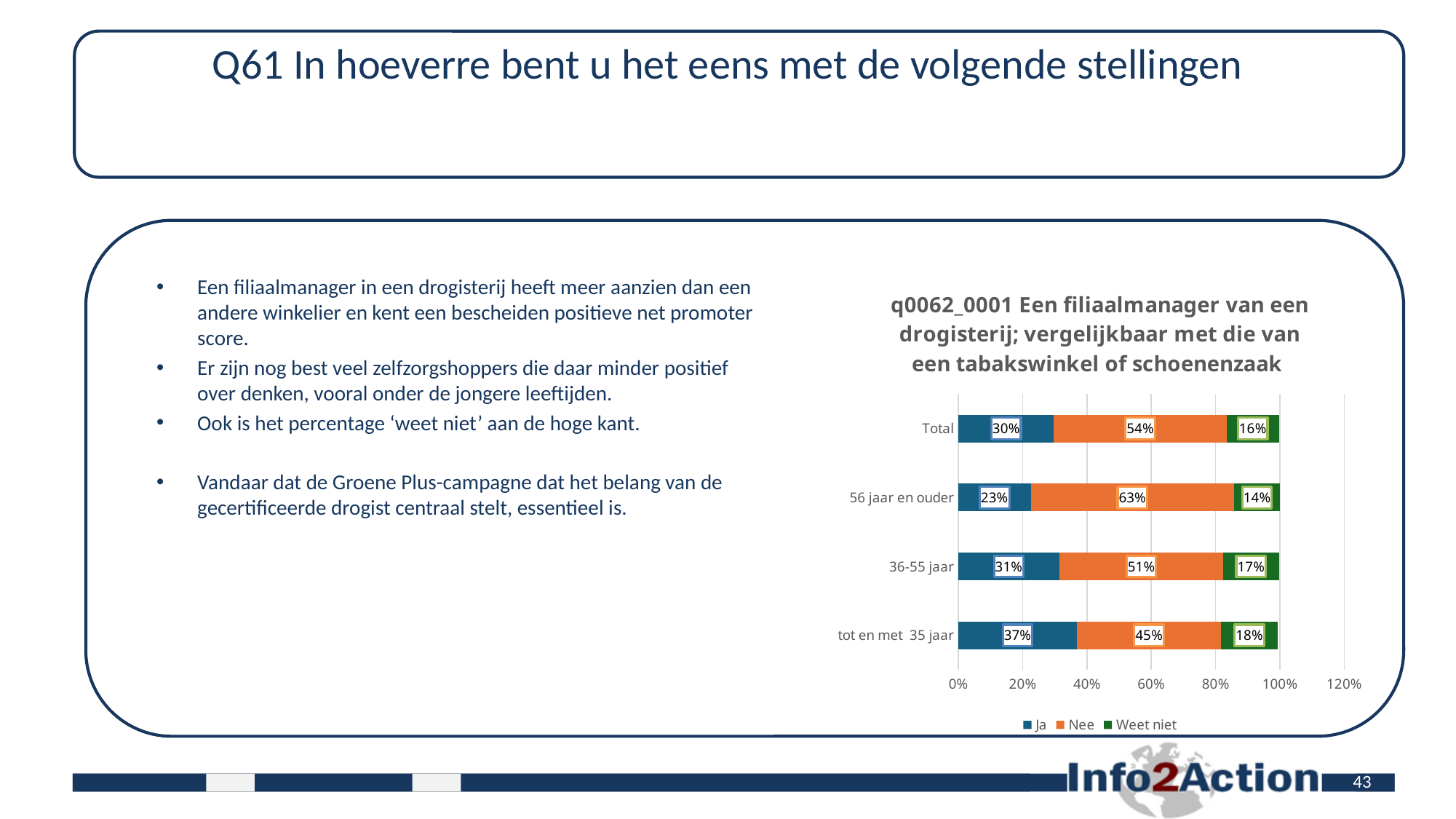
Which category has the lowest 'Nee' value? tot en met 35 jaar What is the 'Nee' value for '56 jaar en ouder'? 63% Which category has the highest 'Ja' value? tot en met 35 jaar What is the difference between the 'Nee' value for '56 jaar en ouder' and the 'Nee' value for '36-55 jaar'? 12% How many series does the legend list? 3 What is the 'Ja' value for the 'Total' category? 30% What kind of chart is shown on the slide? Stacked bar chart Which is larger: the 'Ja' value for '36-55 jaar' or the 'Ja' value for '56 jaar en ouder'? 36-55 jaar What is the 'Weet niet' value for 'tot en met 35 jaar'? 18% What is the total of the stacked bar for '36-55 jaar'? 99% Which series is shown in orange in the chart? Nee How many categories are shown on the y axis of the chart? 4